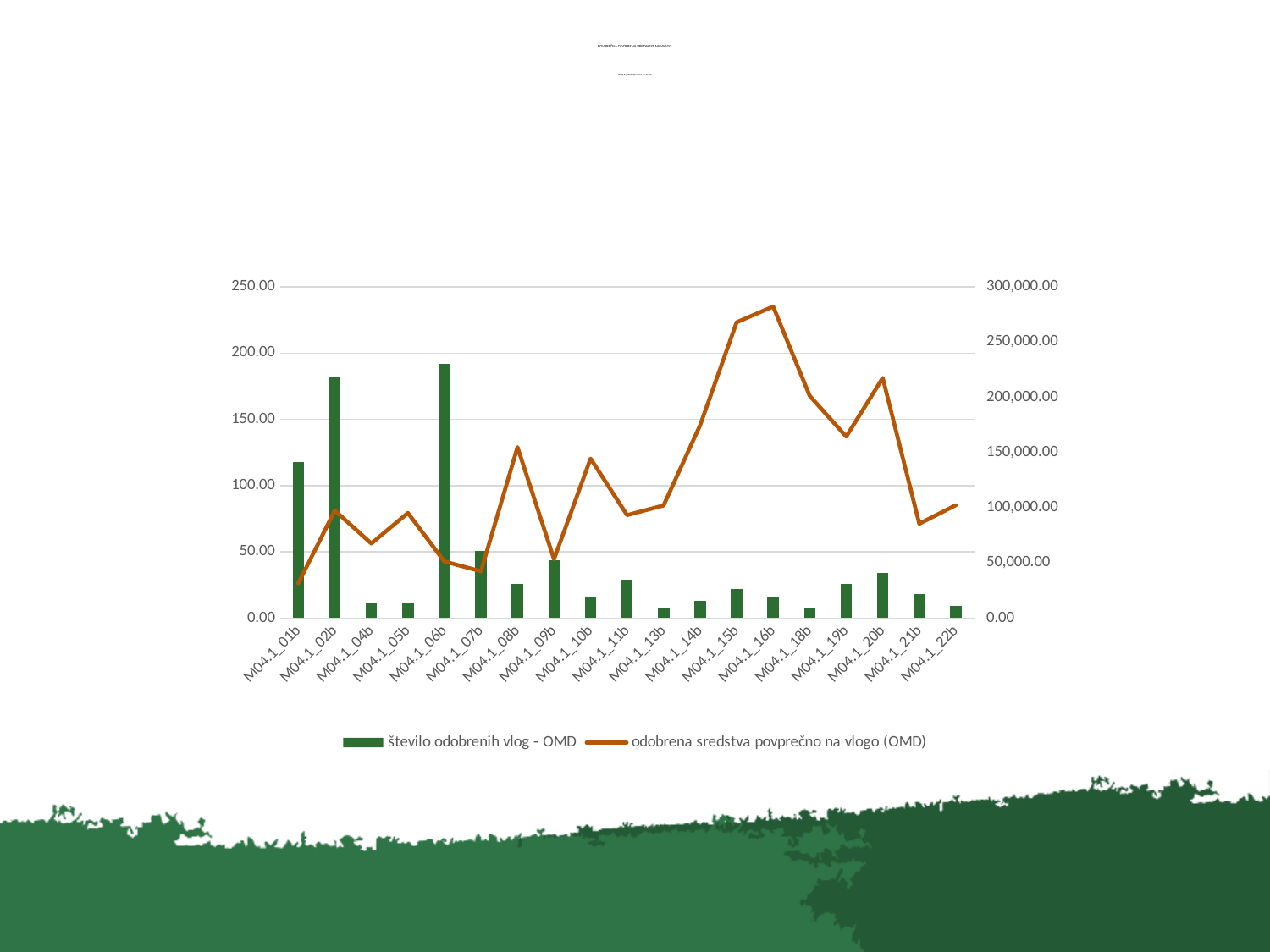
Does the line 'odobrena sredstva povprečno na vlogo (OMD)' rise or fall from M04.1_13b to M04.1_16b? rise Is the line value for M04.1_21b greater or less than 100,000.00? less Which category has the highest value on the line 'odobrena sredstva povprečno na vlogo (OMD)'? M04.1_16b Is the bar value for M04.1_02b greater or less than 150.00? greater Which has the taller bar, M04.1_02b or M04.1_06b? M04.1_06b Which category has the tallest bar for 'število odobrenih vlog - OMD'? M04.1_06b What kind of chart is shown on the slide? A combined bar and line chart Which has the higher line value, M04.1_16b or M04.1_20b? M04.1_16b How many categories are shown on the x axis? 19 Is the line value for M04.1_15b greater or less than 250,000.00? greater How many series does the legend list? 2